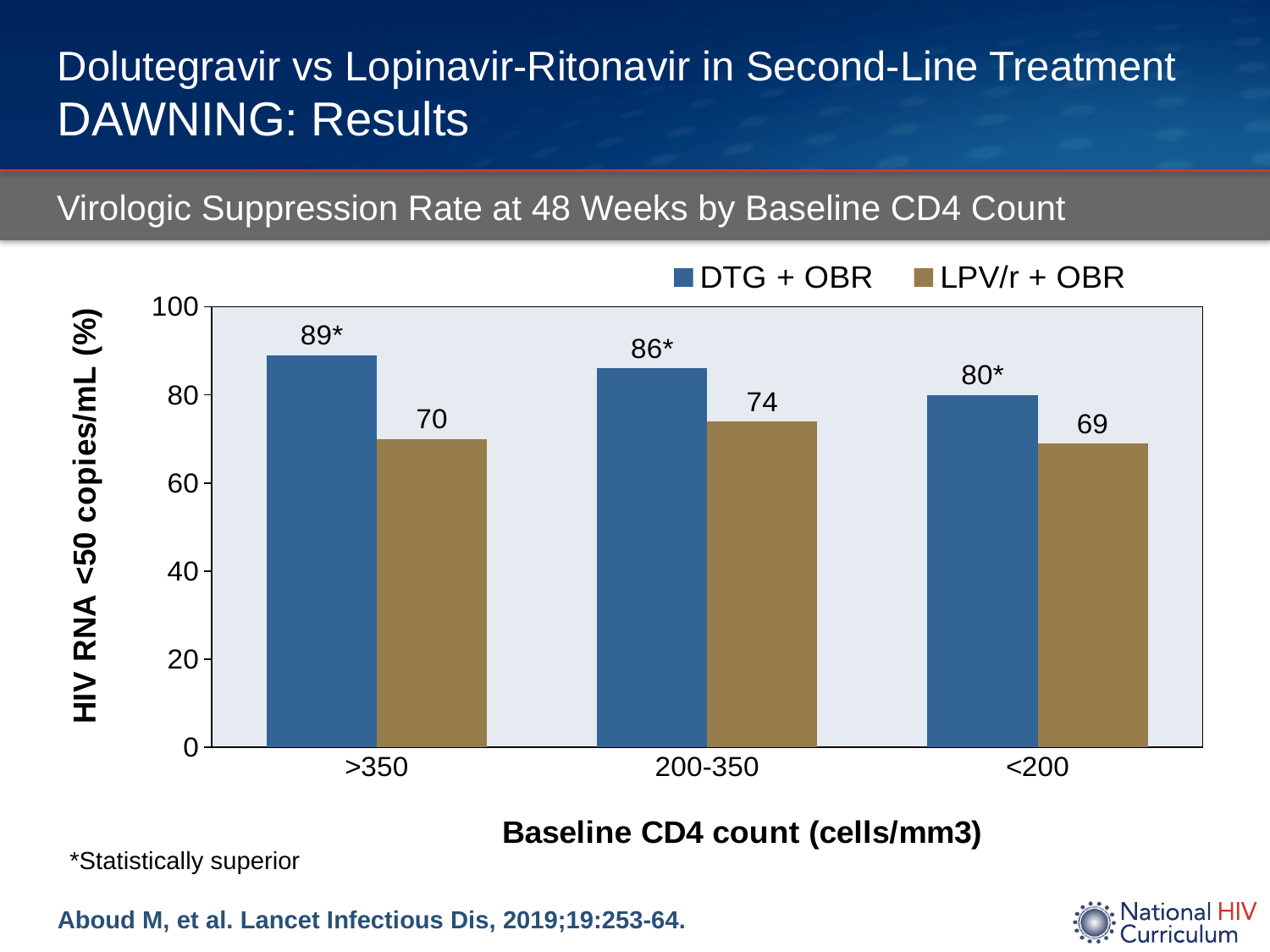
In the <200 group, which treatment has the higher suppression rate, DTG + OBR or LPV/r + OBR? DTG + OBR Which baseline CD4 count group has the highest suppression rate for DTG + OBR? >350 What is the difference between the DTG + OBR and LPV/r + OBR suppression rates in the >350 group? 19 Do the DTG + OBR values rise or fall moving from >350 to <200 along the x axis? Fall Which baseline CD4 count group has the lowest suppression rate for LPV/r + OBR? <200 How many series does the legend list? 2 What is the virologic suppression rate for LPV/r + OBR in the <200 baseline CD4 count group? 69 How many baseline CD4 count categories are shown on the x axis? 3 What is the virologic suppression rate for DTG + OBR in the >350 baseline CD4 count group? 89* Is the LPV/r + OBR value in the 200-350 group greater or less than 80? less What is the virologic suppression rate for LPV/r + OBR in the 200-350 baseline CD4 count group? 74 What kind of chart is shown on the slide? Bar chart